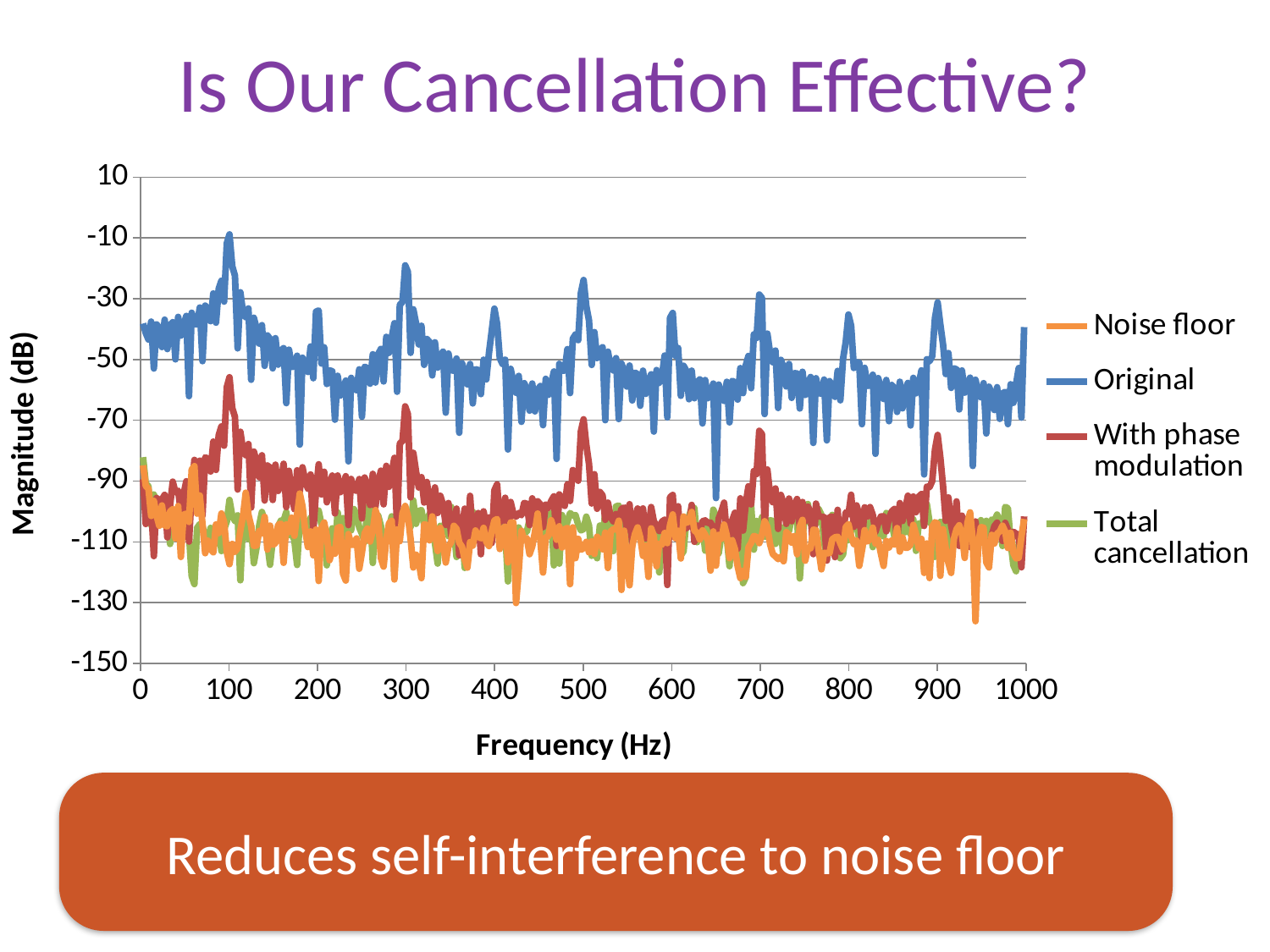
Near 100 Hz, which series has the higher magnitude, Original or With phase modulation? Original Is the peak value of the With phase modulation series near 100 Hz greater or less than -90? greater Is the peak value of the Original series near 300 Hz greater or less than -50? greater Near 700 Hz, which series has the higher magnitude, With phase modulation or Total cancellation? With phase modulation Is the value of the Total cancellation series near 900 Hz greater or less than -70? less How many series does the legend list? 4 Which series has the highest magnitude values across the frequency range? Original What kind of chart is shown on the slide? line chart What is the title of the vertical axis? Magnitude (dB) What are the series names listed in the legend? Noise floor, Original, With phase modulation, Total cancellation